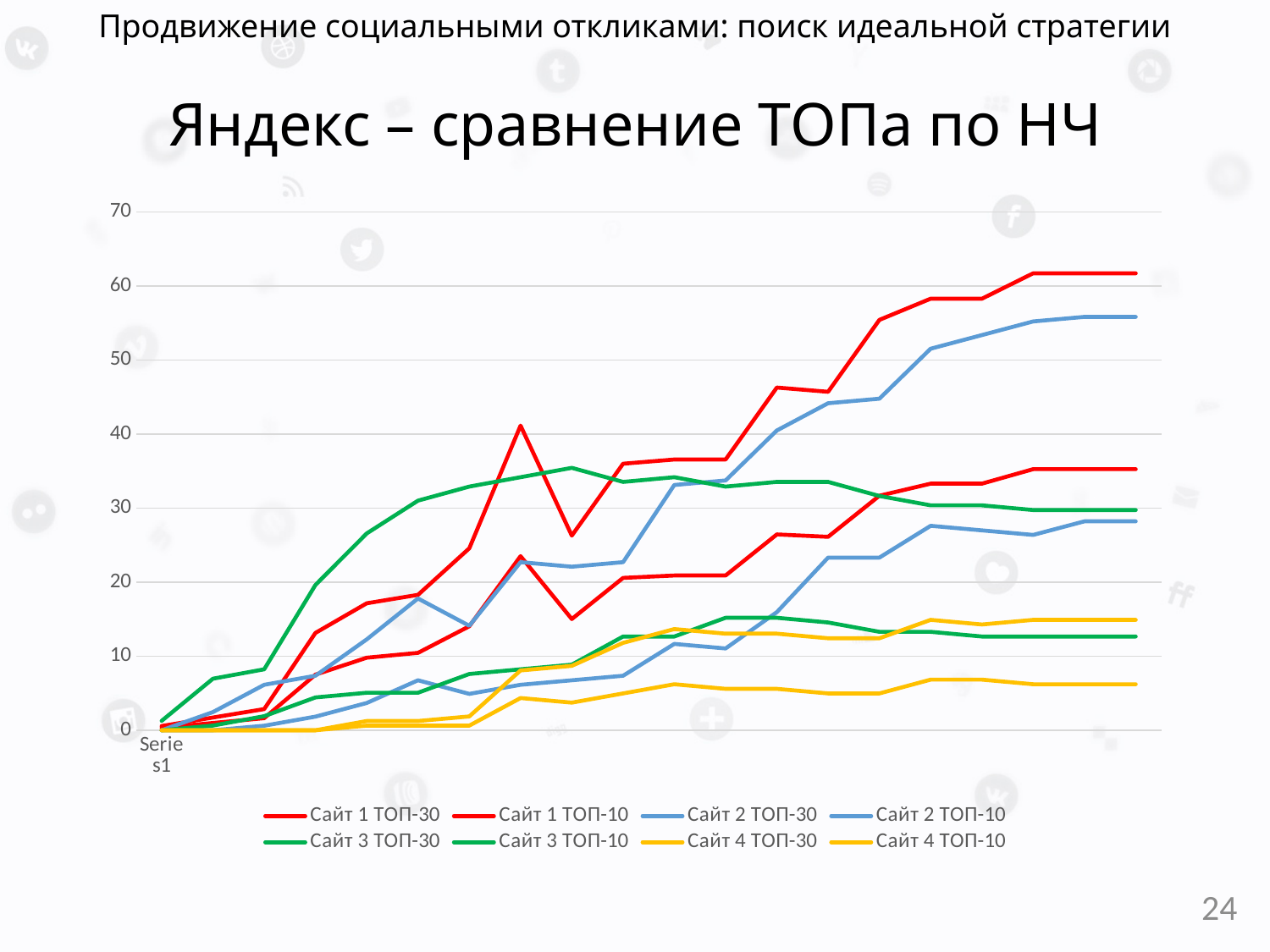
Do the lines generally rise or fall from left to right? rise Which colour of line has the lowest value at the right end of the chart? yellow What is the highest value shown on the vertical axis? 70 Which colour of line reaches the highest value on the chart? red What kind of chart is shown on the slide? line chart At the right end of the chart, which is higher: the highest red line or the highest blue line? the highest red line Is the final value of the lowest yellow line greater or less than 10? less What is the title of the chart? Яндекс – сравнение ТОПа по НЧ Is the final value of the highest blue line greater or less than 50? greater Is the final value of the highest red line greater or less than 60? greater How many series does the legend list? 8